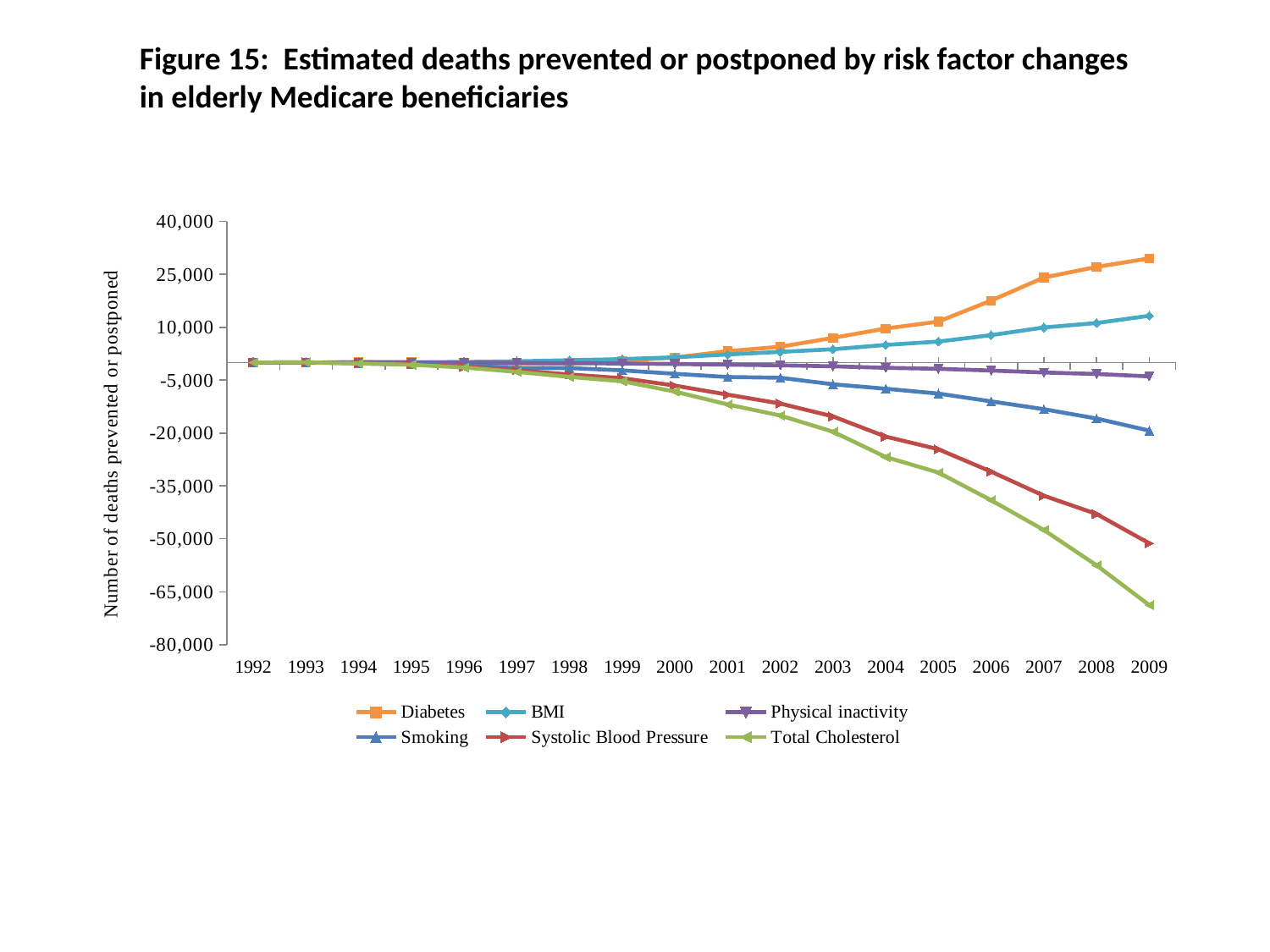
Is the value for BMI in 2009 greater or less than 10,000? greater Which series has the highest value in 2009? Diabetes What kind of chart is shown on the slide? Line chart Is the value for Total Cholesterol in 2009 greater or less than -65,000? less What is the label on the vertical axis? Number of deaths prevented or postponed In 2009, which is larger, the value for Diabetes or the value for BMI? Diabetes Is the value for Systolic Blood Pressure in 2007 greater or less than -35,000? less How many years are plotted along the x axis? 18 Which series has the lowest value in 2009? Total Cholesterol How many series does the legend list? 6 Does the Diabetes series rise or fall from 1992 to 2009? Rise